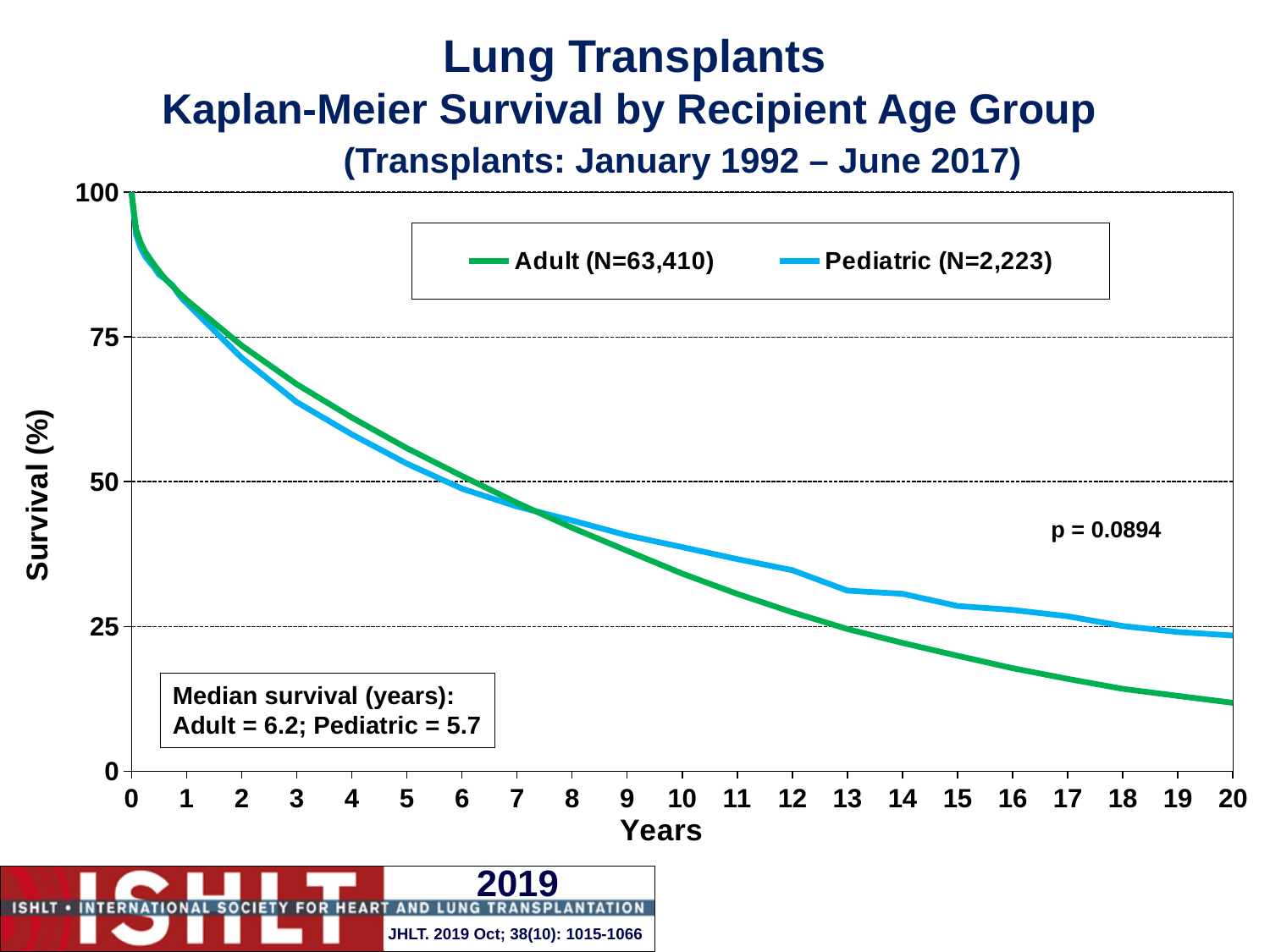
What is the p-value shown on the chart? 0.0894 Which group has the longer median survival, Adult or Pediatric? Adult What colour is the line for the Pediatric group? Blue What is the difference in median survival (years) between the Adult and Pediatric groups? 0.5 What is the median survival in years for the Pediatric group? 5.7 How many series does the legend list? 2 Do the survival curves rise or fall as years increase? Fall What is the median survival in years for the Adult group? 6.2 At 15 years, which group has the higher survival, Adult or Pediatric? Pediatric What kind of chart is shown on the slide? Line chart Is the Adult survival at 20 years greater or less than 25%? less What is the N for the Adult group in the legend? 63,410